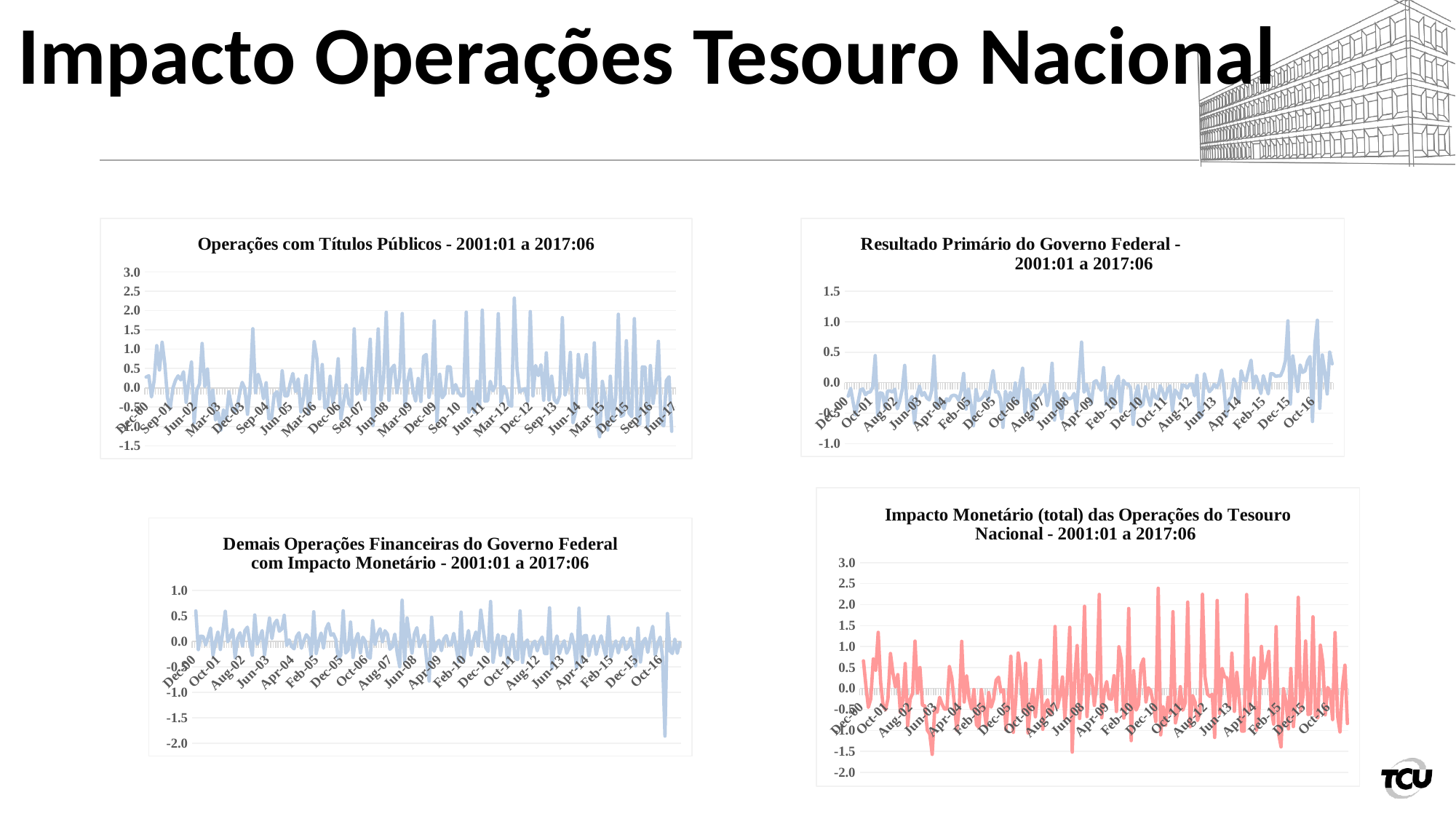
In the 'Demais Operações Financeiras do Governo Federal com Impacto Monetário' chart, is the lowest value (near Oct-16) greater or less than -1.5? less In the 'Impacto Monetário (total) das Operações do Tesouro Nacional' chart, is the lowest value greater or less than -1.0? less In the 'Resultado Primário do Governo Federal' chart, is the highest value greater or less than 0.5? greater What colour is the line in the 'Impacto Monetário (total) das Operações do Tesouro Nacional' chart? Red What is the title of the chart in the top-right of the slide? Resultado Primário do Governo Federal - 2001:01 a 2017:06 How many charts are shown on the slide? 4 What kind of chart is 'Operações com Títulos Públicos - 2001:01 a 2017:06'? Line chart